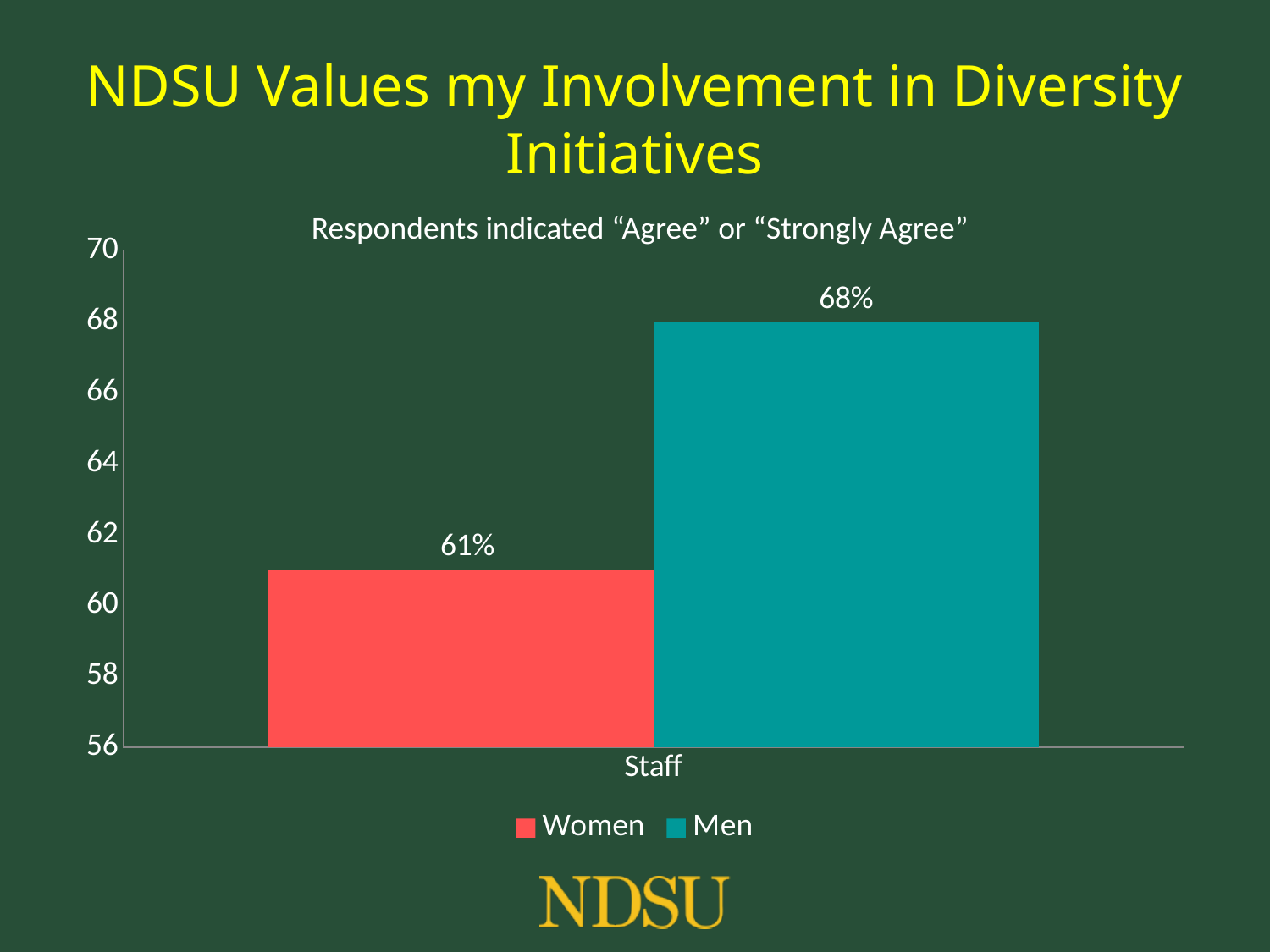
Is the value for Women greater or less than 62? less What colour represents Men in the chart? Teal What percentage of men staff indicated "Agree" or "Strongly Agree"? 68% What percentage of women staff indicated "Agree" or "Strongly Agree"? 61% Which series has the higher value for Staff, Women or Men? Men Which series has the lowest value on the chart? Women What kind of chart is shown on the slide? Bar chart How many series does the legend list? 2 What is the chart's subtitle above the plot area? Respondents indicated "Agree" or "Strongly Agree" How many categories are shown on the x axis? 1 Is the value for Men greater or less than 66? greater What is the difference in percentage points between the Men and Women values for Staff? 7